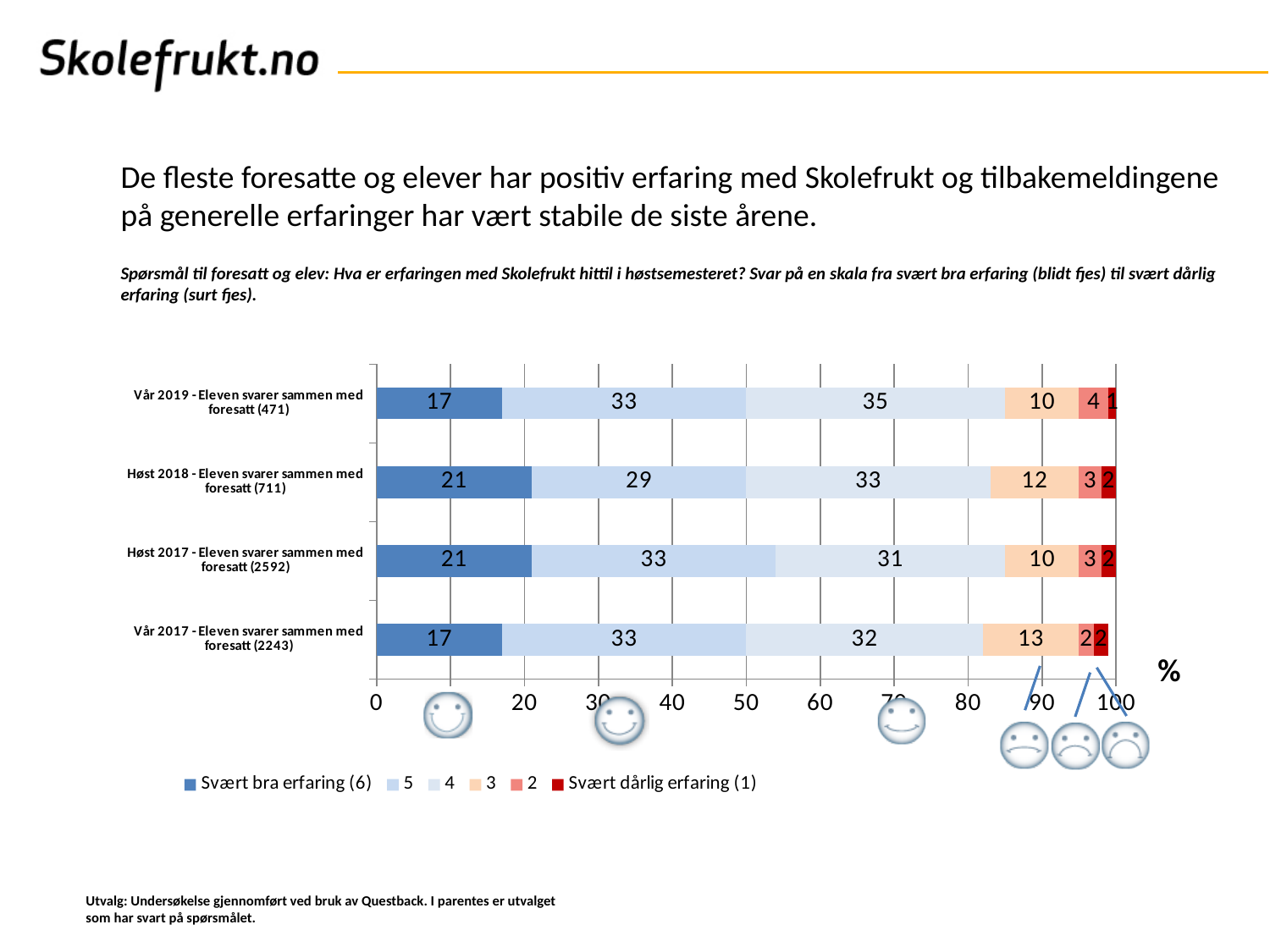
What is the difference between the 'Svært bra erfaring (6)' values for Høst 2018 (711) and Vår 2019 (471)? 4 What is the value for series '3' in the 'Vår 2017 - Eleven svarer sammen med foresatt (2243)' bar? 13 Which category has the highest value for series '4'? Vår 2019 - Eleven svarer sammen med foresatt (471) What is the label of the first (dark blue) series in the legend? Svært bra erfaring (6) What is the value for series '5' in the 'Høst 2018 - Eleven svarer sammen med foresatt (711)' bar? 29 How many series does the legend list? 6 What kind of chart is shown on the slide? Stacked bar chart What is the value for series '4' in the 'Høst 2017 - Eleven svarer sammen med foresatt (2592)' bar? 31 What is the value for 'Svært bra erfaring (6)' in the 'Vår 2019 - Eleven svarer sammen med foresatt (471)' bar? 17 Which is larger: the series '3' value for Høst 2018 (711) or for Høst 2017 (2592)? Høst 2018 (711) Which category has the lowest value for series '5'? Høst 2018 - Eleven svarer sammen med foresatt (711) How many categories (survey rounds) are shown on the chart? 4